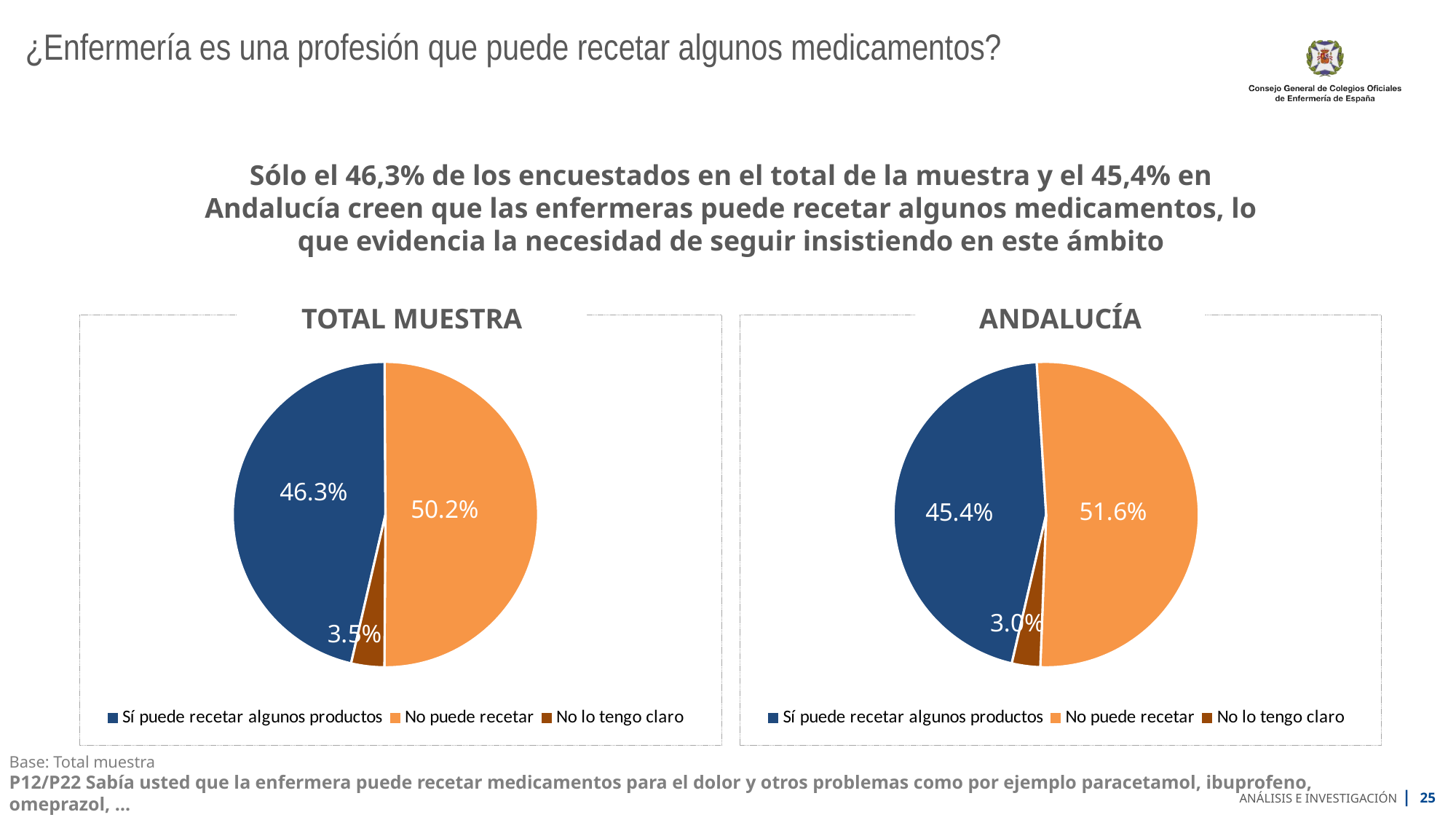
In the ANDALUCÍA chart, which category has the smallest share? No lo tengo claro Is the 'No lo tengo claro' share larger in the TOTAL MUESTRA chart or in the ANDALUCÍA chart? TOTAL MUESTRA How many slices does the TOTAL MUESTRA pie chart have? 3 In the ANDALUCÍA chart, which colour represents 'No puede recetar'? Orange In the ANDALUCÍA chart, what percentage corresponds to 'Sí puede recetar algunos productos'? 45.4% In the TOTAL MUESTRA chart, which category has the largest share? No puede recetar In the TOTAL MUESTRA chart, what percentage corresponds to 'No lo tengo claro'? 3.5% In the ANDALUCÍA chart, what percentage corresponds to 'No puede recetar'? 51.6% What type of chart is used for ANDALUCÍA? Pie chart In the TOTAL MUESTRA chart, what percentage corresponds to 'Sí puede recetar algunos productos'? 46.3% In the TOTAL MUESTRA chart, what is the difference between 'No puede recetar' and 'No lo tengo claro'? 46.7% In the ANDALUCÍA chart, what is the difference between 'No puede recetar' and 'Sí puede recetar algunos productos'? 6.2%